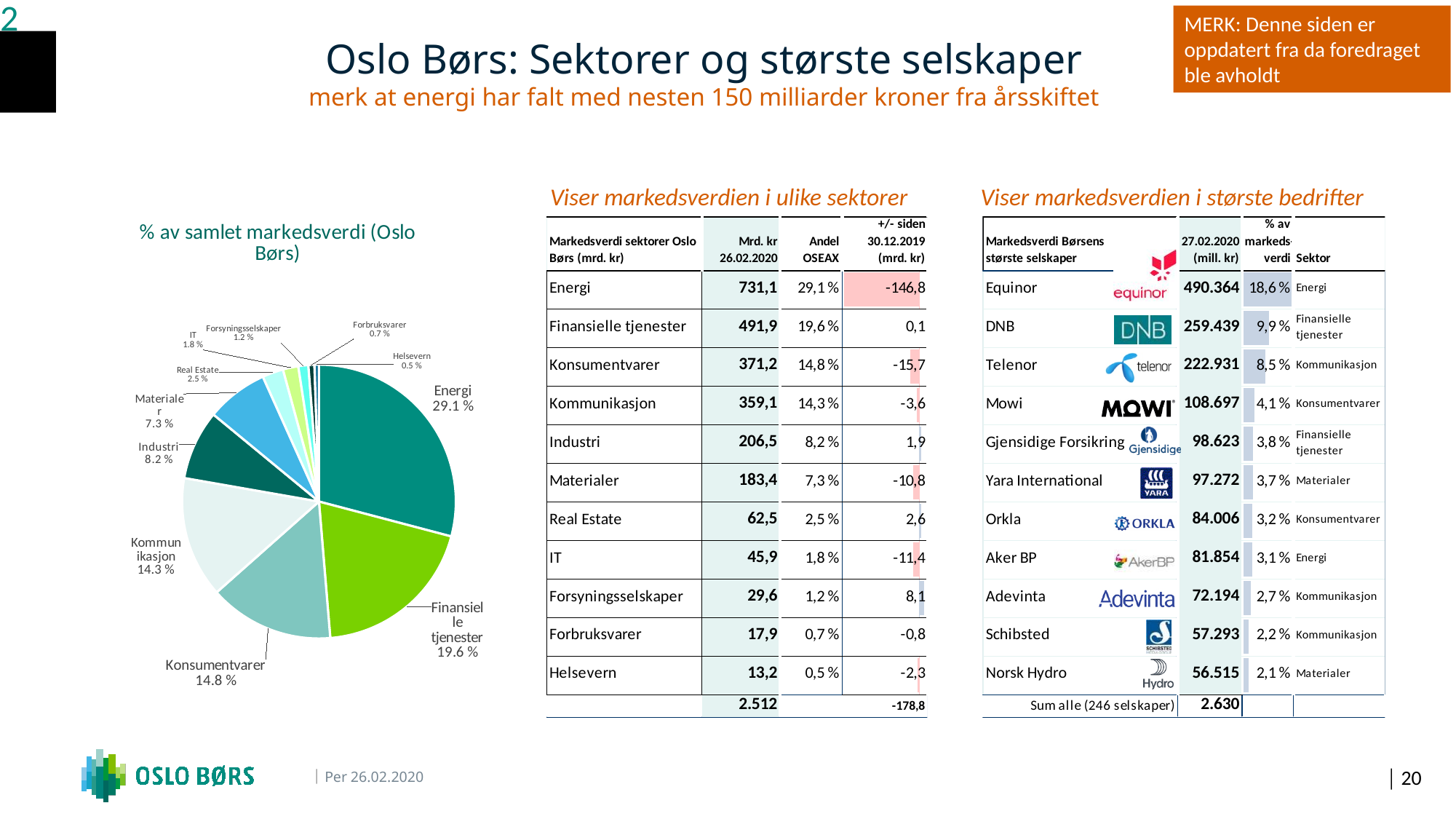
In the pie chart '% av samlet markedsverdi (Oslo Børs)', what share does Energi have? 29.1 % In the pie chart '% av samlet markedsverdi (Oslo Børs)', what share does Kommunikasjon have? 14.3 % In the pie chart '% av samlet markedsverdi (Oslo Børs)', what share does Materialer have? 7.3 % In the pie chart '% av samlet markedsverdi (Oslo Børs)', which sector has the smallest slice? Helsevern In the pie chart '% av samlet markedsverdi (Oslo Børs)', which sector has the largest slice? Energi In the pie chart '% av samlet markedsverdi (Oslo Børs)', which is larger: Konsumentvarer or Industri? Konsumentvarer What kind of chart is shown on the left of the slide under the title '% av samlet markedsverdi (Oslo Børs)'? pie chart How many slices does the pie chart '% av samlet markedsverdi (Oslo Børs)' have? 11 In the pie chart '% av samlet markedsverdi (Oslo Børs)', what is the difference in percentage points between Energi and Finansielle tjenester? 9.5 In the pie chart '% av samlet markedsverdi (Oslo Børs)', what share does Helsevern have? 0.5 % What is the title of the pie chart on the left of the slide? % av samlet markedsverdi (Oslo Børs) In the pie chart '% av samlet markedsverdi (Oslo Børs)', what share does Finansielle tjenester have? 19.6 %